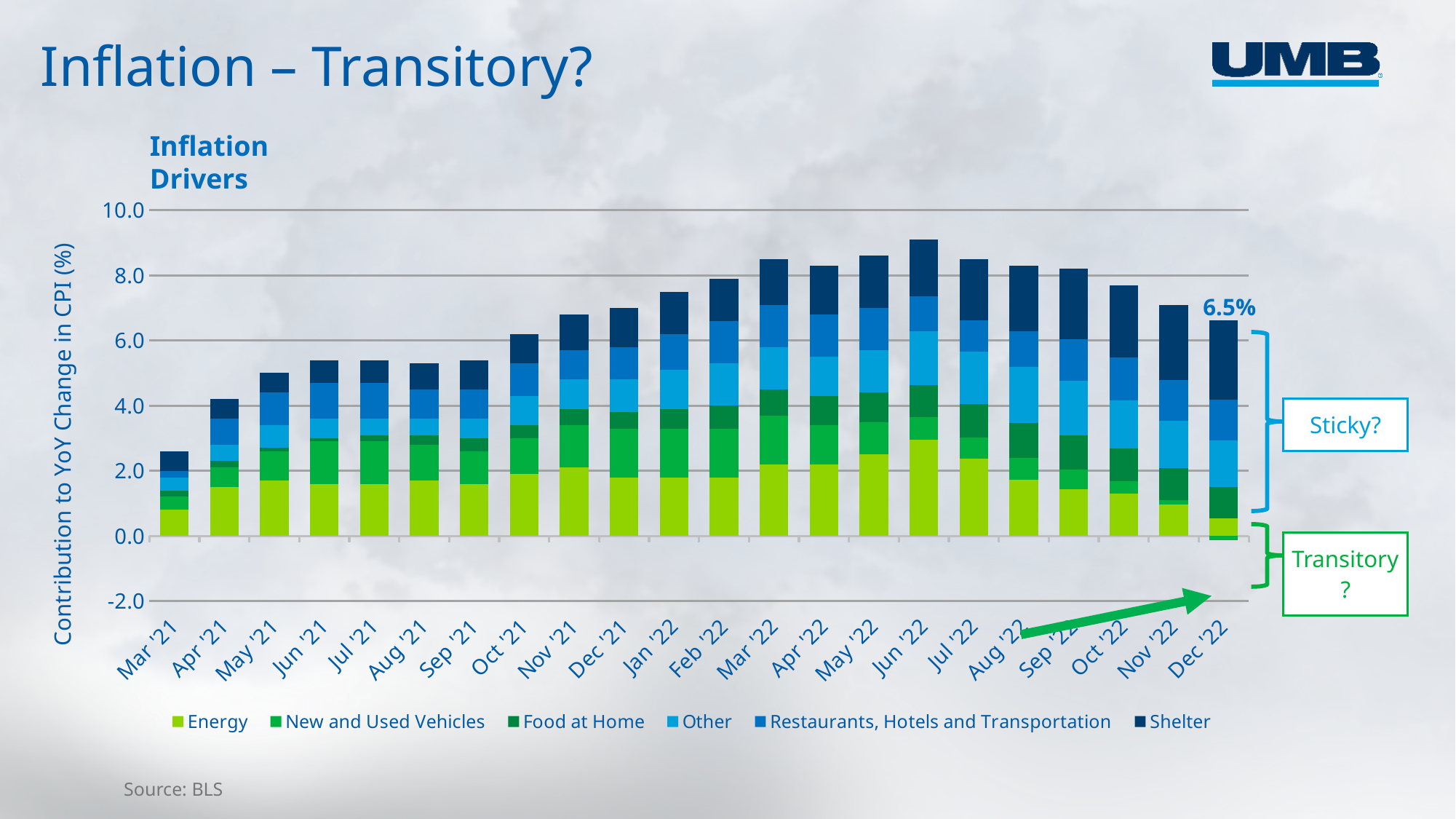
How many months are plotted along the x axis of the Inflation Drivers chart? 22 What is the y-axis title of the Inflation Drivers chart? Contribution to YoY Change in CPI (%) Is the total bar for Mar '21 greater or less than 4.0? less Which month has the lowest total bar in the Inflation Drivers chart? Mar '21 Is the total bar for Jun '22 greater or less than 8.0? greater How many series does the legend of the Inflation Drivers chart list? 6 Which month has the highest total bar in the Inflation Drivers chart? Jun '22 Which has the larger total bar, Jun '22 or Dec '22? Jun '22 Do the total bars rise or fall from Jun '22 to Dec '22? Fall Is the total bar for Dec '21 greater or less than 6.0? greater What is the labelled total contribution to YoY CPI change for Dec '22? 6.5% What kind of chart is shown on the slide? Stacked bar chart